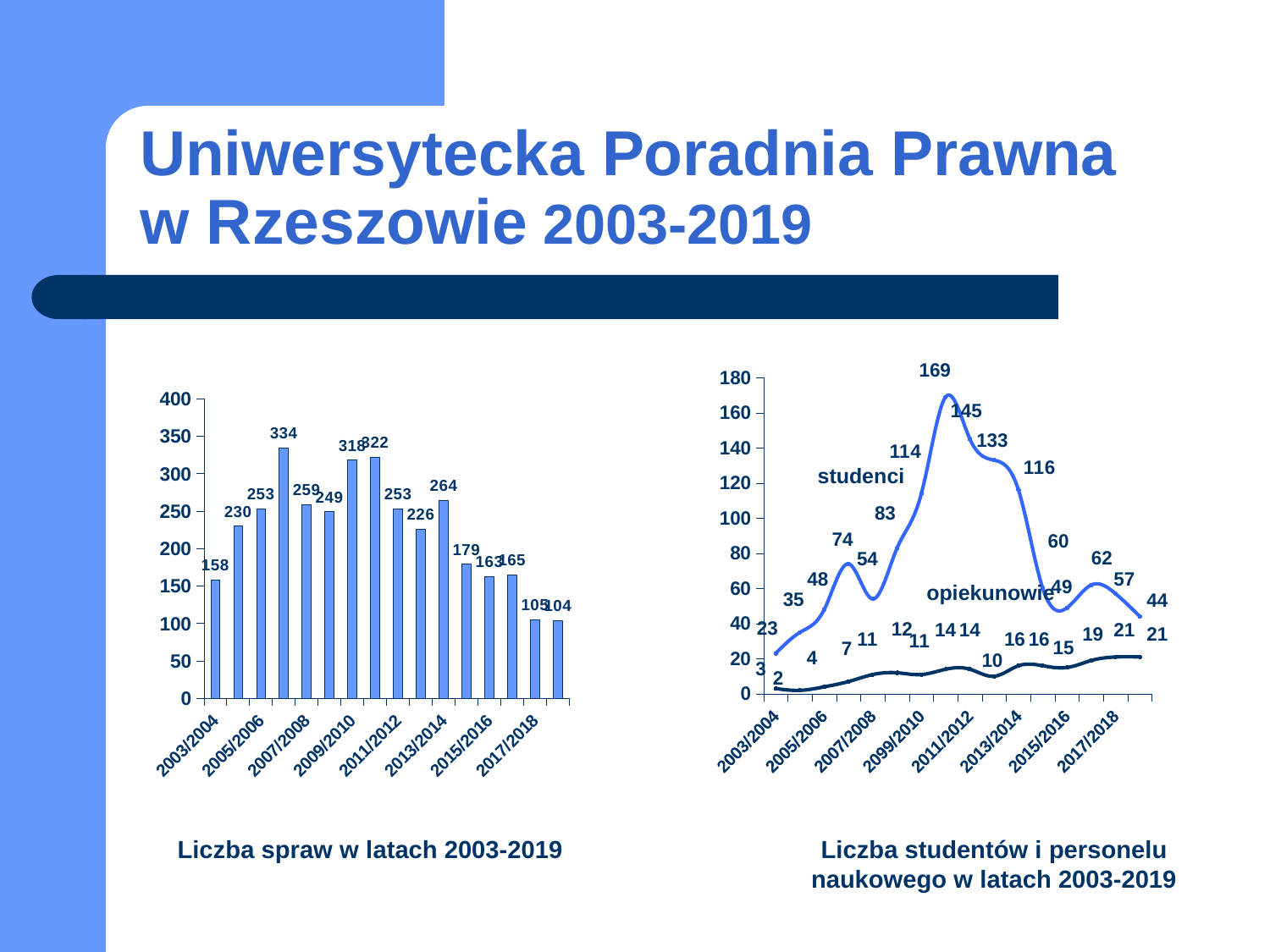
In the left chart 'Liczba spraw w latach 2003-2019', what is the difference between the values for 2005/2006 and 2003/2004? 95 In the right chart 'Liczba studentów i personelu naukowego w latach 2003-2019', which series has the larger value for 2003/2004, 'studenci' or 'opiekunowie'? studenci How many series are plotted in the right chart 'Liczba studentów i personelu naukowego w latach 2003-2019'? 2 In the left chart 'Liczba spraw w latach 2003-2019', what is the value for 2009/2010? 318 What kind of chart is the right chart, 'Liczba studentów i personelu naukowego w latach 2003-2019'? line chart In the right chart 'Liczba studentów i personelu naukowego w latach 2003-2019', what is the highest value of the 'studenci' series? 169 How many bars are plotted in the left chart 'Liczba spraw w latach 2003-2019'? 16 In the left chart 'Liczba spraw w latach 2003-2019', what is the highest value shown? 334 In the right chart 'Liczba studentów i personelu naukowego w latach 2003-2019', what is the value of 'opiekunowie' for 2003/2004? 3 In the left chart 'Liczba spraw w latach 2003-2019', what is the value for 2003/2004? 158 In the left chart 'Liczba spraw w latach 2003-2019', what is the lowest value shown? 104 What kind of chart is the left chart, 'Liczba spraw w latach 2003-2019'? bar chart